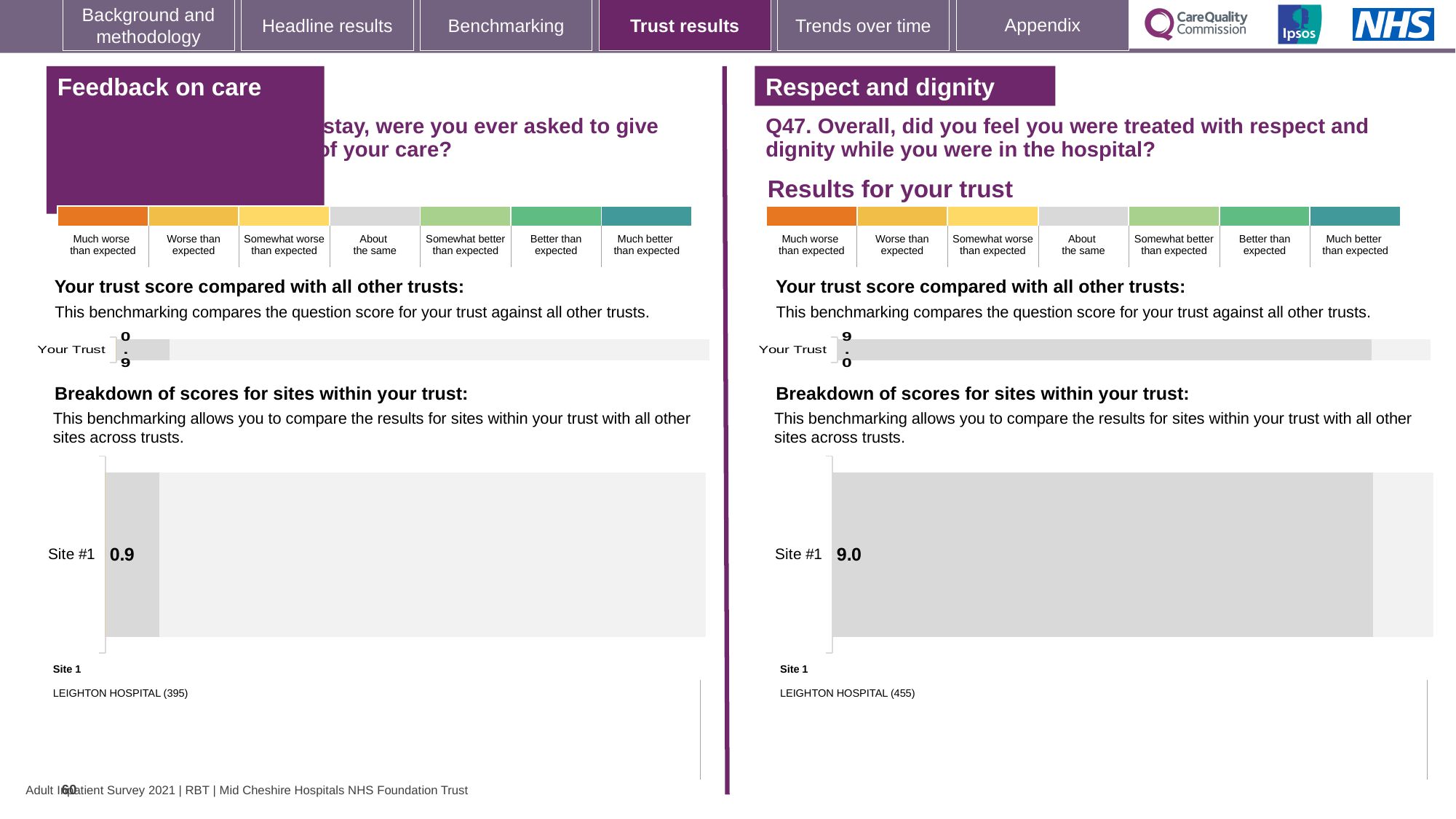
In the 'Respect and dignity' section, what is the score shown for Site #1? 9.0 How many sites are shown in the site breakdown chart of the 'Feedback on care' section? 1 In the 'Feedback on care' section, what is the score shown for Site #1? 0.9 Which site is listed as Site 1 in the 'Feedback on care' section? LEIGHTON HOSPITAL (395) In the 'Feedback on care' section, what is the score shown for Your Trust? 0.9 What is the difference between the Site #1 score in the 'Respect and dignity' section and the Site #1 score in the 'Feedback on care' section? 8.1 In the 'Respect and dignity' section, what is the score shown for Your Trust? 9.0 Which is larger: the Site #1 score in the 'Feedback on care' section or the Site #1 score in the 'Respect and dignity' section? Respect and dignity How many sites are shown in the site breakdown chart of the 'Respect and dignity' section? 1 Which site is listed as Site 1 in the 'Respect and dignity' section? LEIGHTON HOSPITAL (455) What kind of chart is used to show the Site #1 score in the 'Respect and dignity' section? Bar chart Is the Site #1 score in the 'Respect and dignity' section greater or less than 5? greater